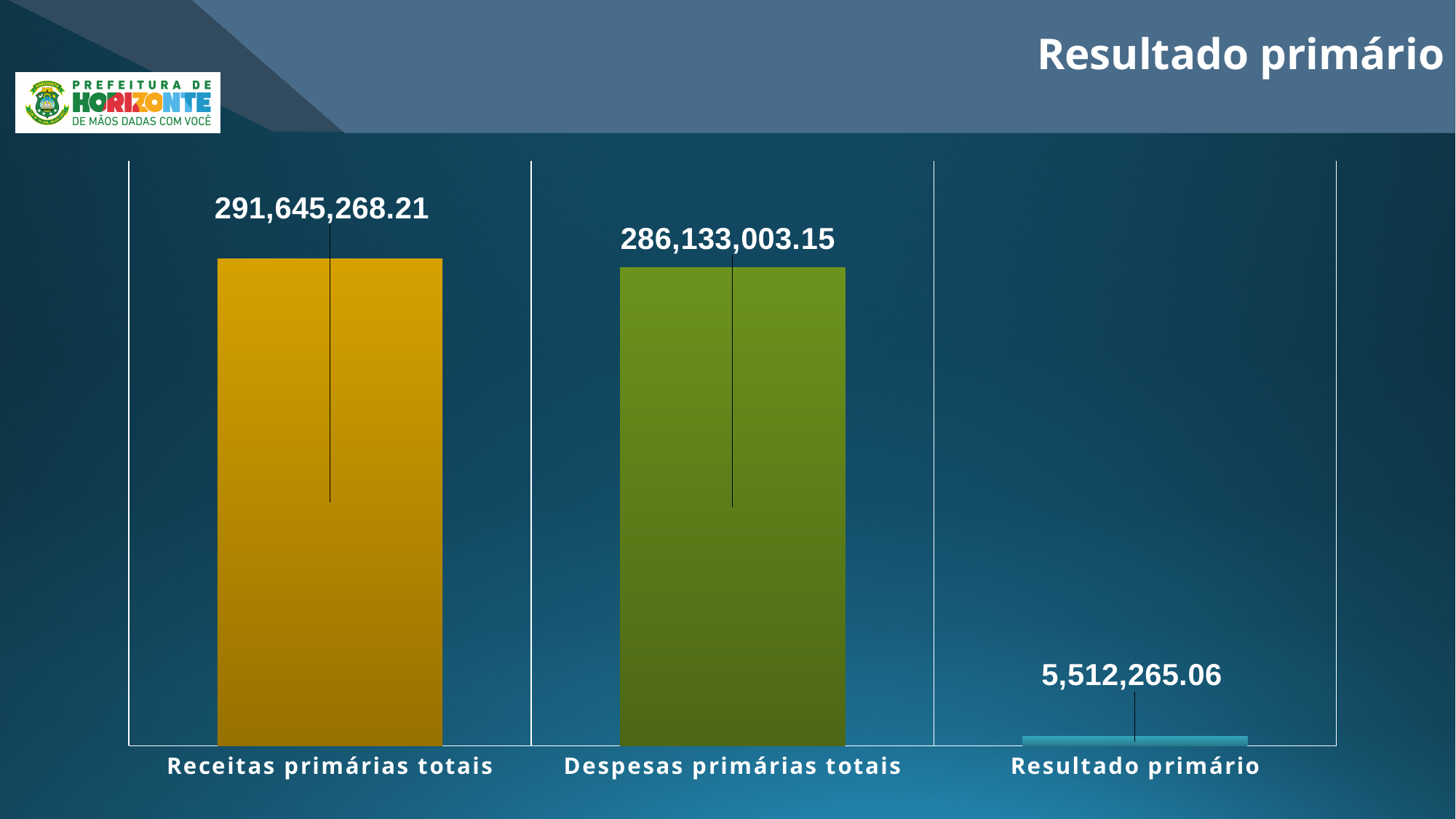
What is the title of the slide? Resultado primário Which category has the lowest value? Resultado primário What kind of chart is shown on the slide? Bar chart What is the value for Despesas primárias totais? 286,133,003.15 What is the difference between Receitas primárias totais and Despesas primárias totais? 5,512,265.06 What is the value for Receitas primárias totais? 291,645,268.21 What colour is the bar for Despesas primárias totais? Green Which is larger, Despesas primárias totais or Resultado primário? Despesas primárias totais How many categories are shown in the chart? 3 Which is larger, Receitas primárias totais or Despesas primárias totais? Receitas primárias totais Which category has the highest value? Receitas primárias totais What is the value for Resultado primário? 5,512,265.06